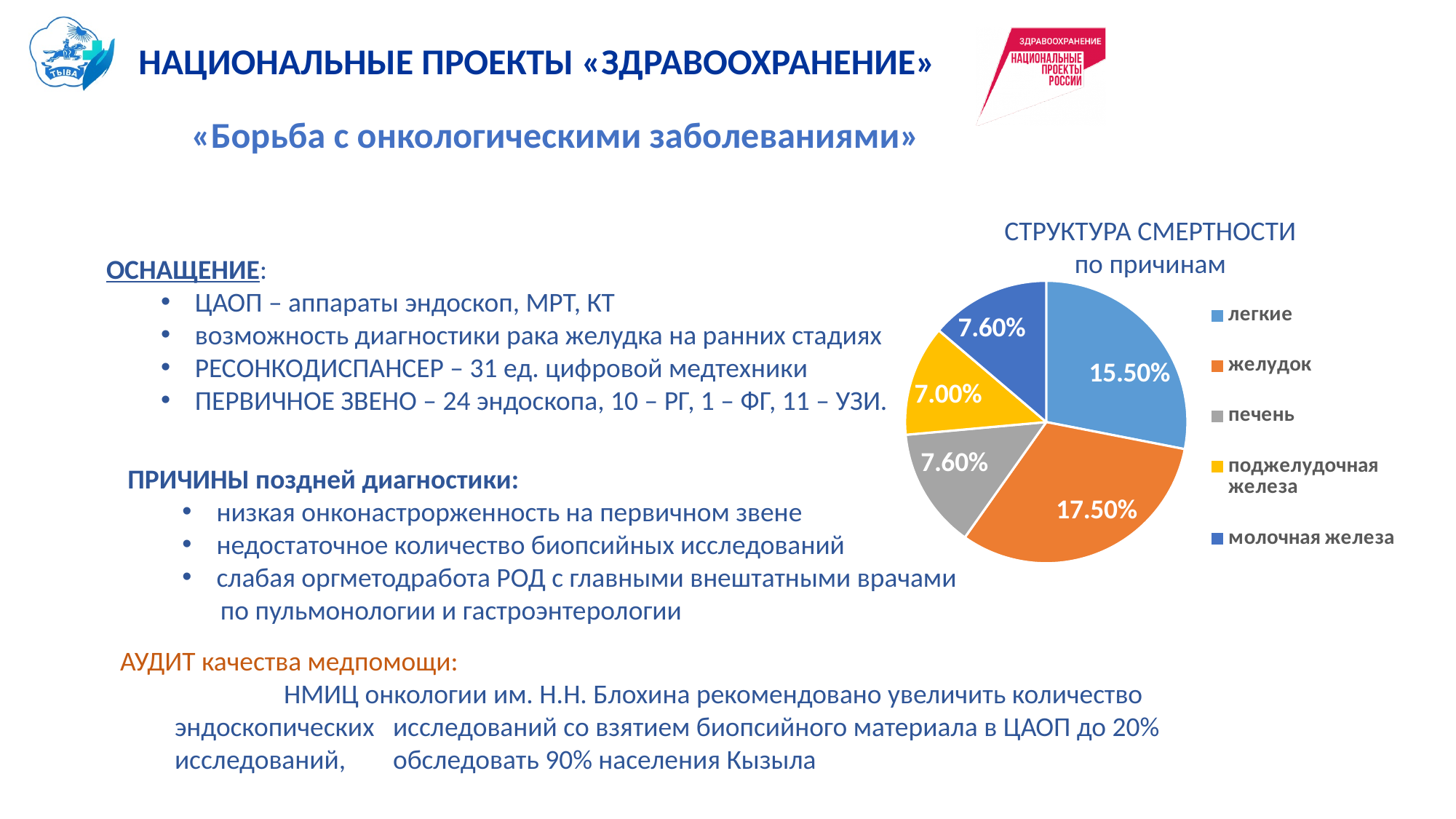
Which is larger, the value for 'легкие' or the value for 'печень'? легкие What is the difference between the values for 'желудок' and 'легкие'? 2.00% What value is shown for the 'легкие' slice? 15.50% Which category has the smallest slice in the pie chart? поджелудочная железа What colour is the 'молочная железа' slice in the pie chart? blue Which category has the largest slice in the pie chart? желудок How many categories does the legend of the pie chart list? 5 What type of chart is shown on the slide? pie chart What value is shown for the 'печень' slice? 7.60% What value is shown for the 'поджелудочная железа' slice? 7.00% What value is shown for the 'желудок' slice? 17.50% What is the title of the chart? СТРУКТУРА СМЕРТНОСТИ по причинам